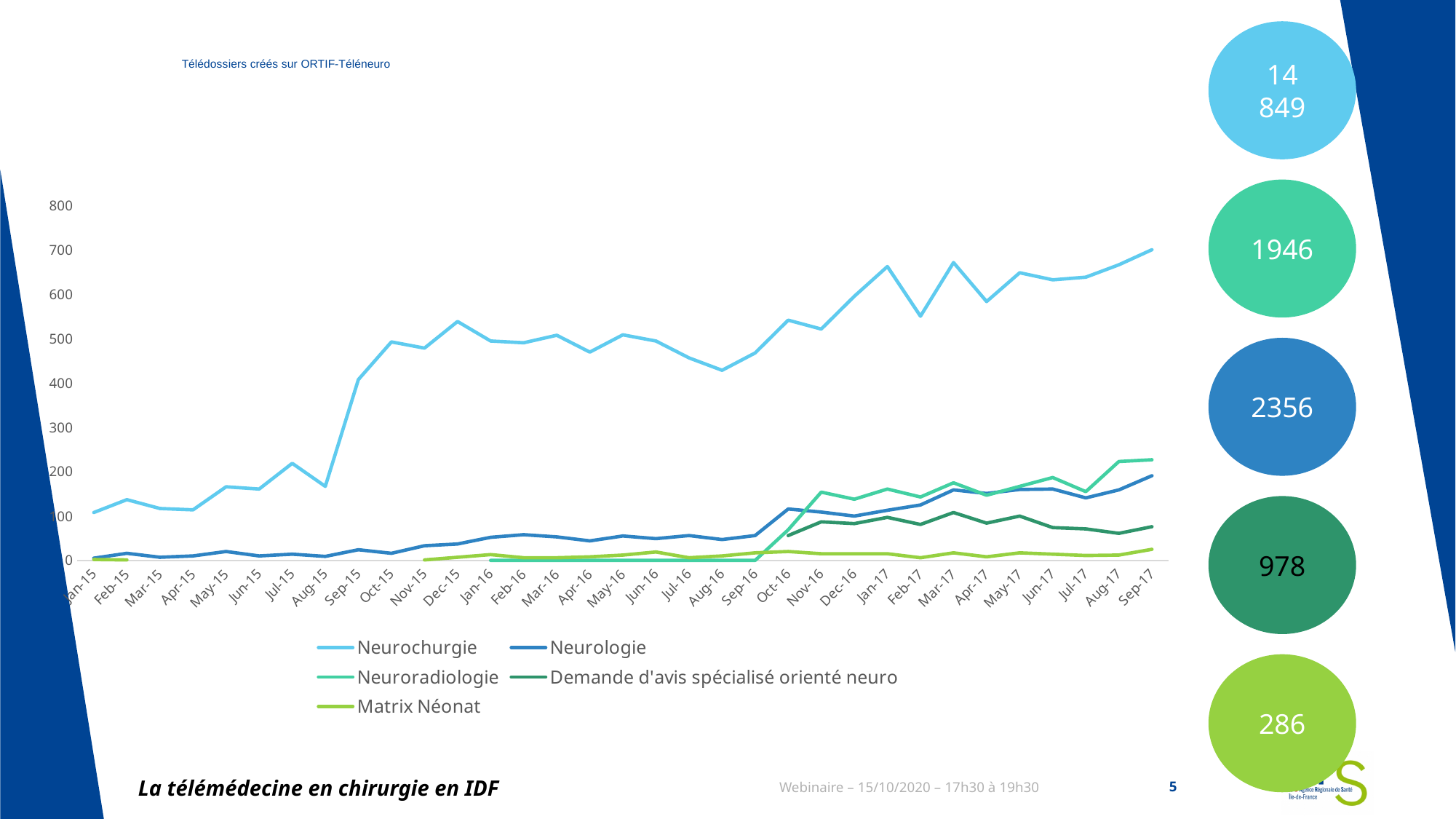
Does the Neurochurgie series rise or fall overall from Jan-15 to Sep-17? rise Which series has the highest values throughout the chart? Neurochurgie Is the value for Neurochurgie at Aug-16 greater or less than 400? greater Is the value for Neuroradiologie at Sep-17 greater or less than 200? greater At Sep-17, which is larger: Neuroradiologie or Neurologie? Neuroradiologie Which series has the lowest values at Sep-17? Matrix Néonat What is the title of the chart? Télédossiers créés sur ORTIF-Téléneuro What kind of chart is shown on the slide? line chart How many months are plotted along the x axis of the chart? 33 How many series does the chart legend list? 5 Is the value for Neurochurgie at Jan-17 greater or less than 600? greater